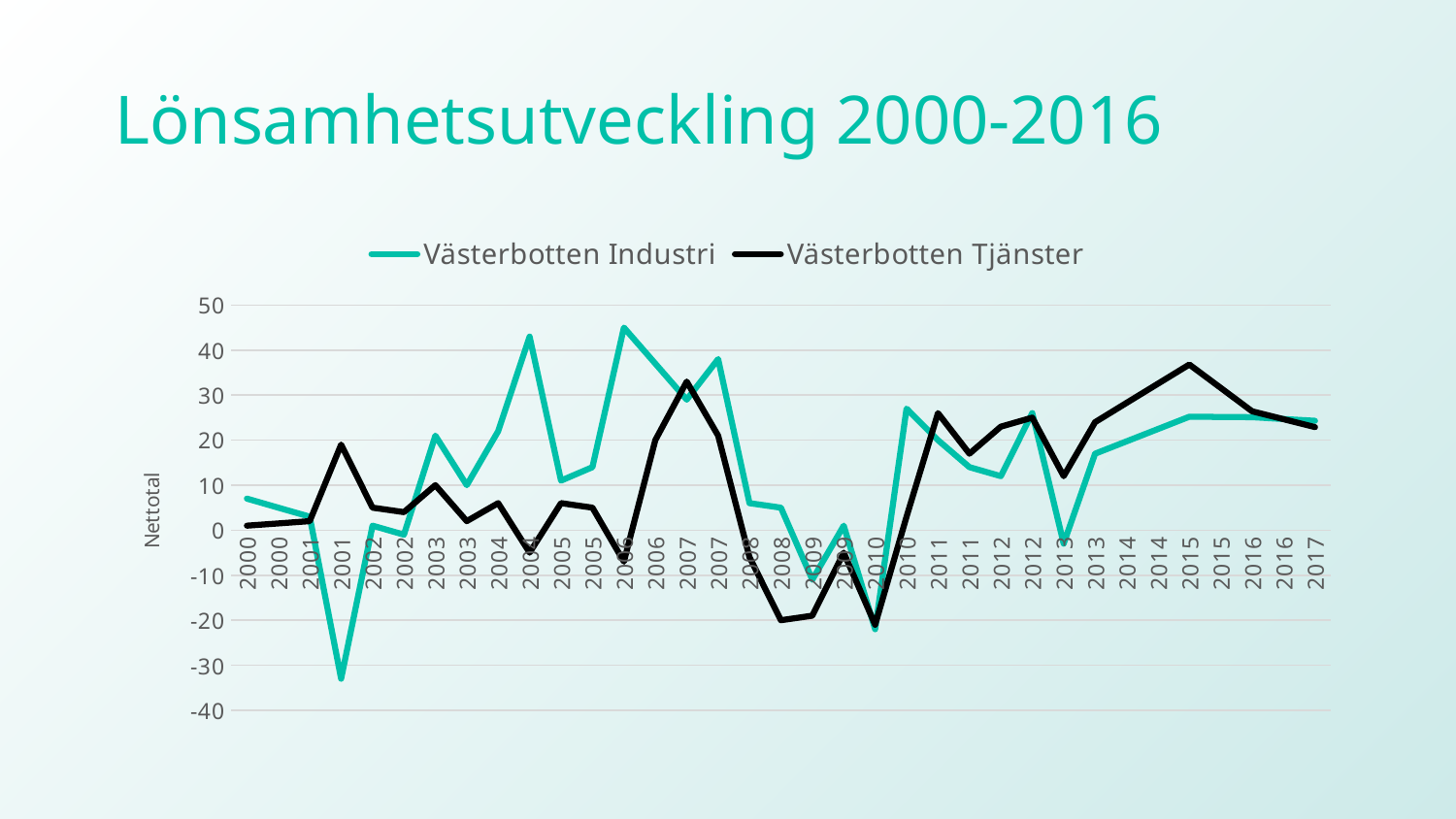
Is the lowest value of Västerbotten Industri (in 2001) greater or less than -30? less What is the label on the vertical axis? Nettotal What is the title of the chart? Lönsamhetsutveckling 2000-2016 In which year does the Västerbotten Industri line reach its highest value? 2006 At the 2006 peak, which series has the larger value, Västerbotten Industri or Västerbotten Tjänster? Västerbotten Industri Is the peak value of Västerbotten Tjänster in 2015 greater or less than 30? greater How many series does the legend list? 2 Is the peak value of Västerbotten Industri in 2006 greater or less than 40? greater Does the Västerbotten Tjänster line rise or fall from 2015 to 2017? Fall What kind of chart is shown on the slide? Line chart In which year does the Västerbotten Tjänster line reach its highest value? 2015 In which year does the Västerbotten Industri line reach its lowest value? 2001